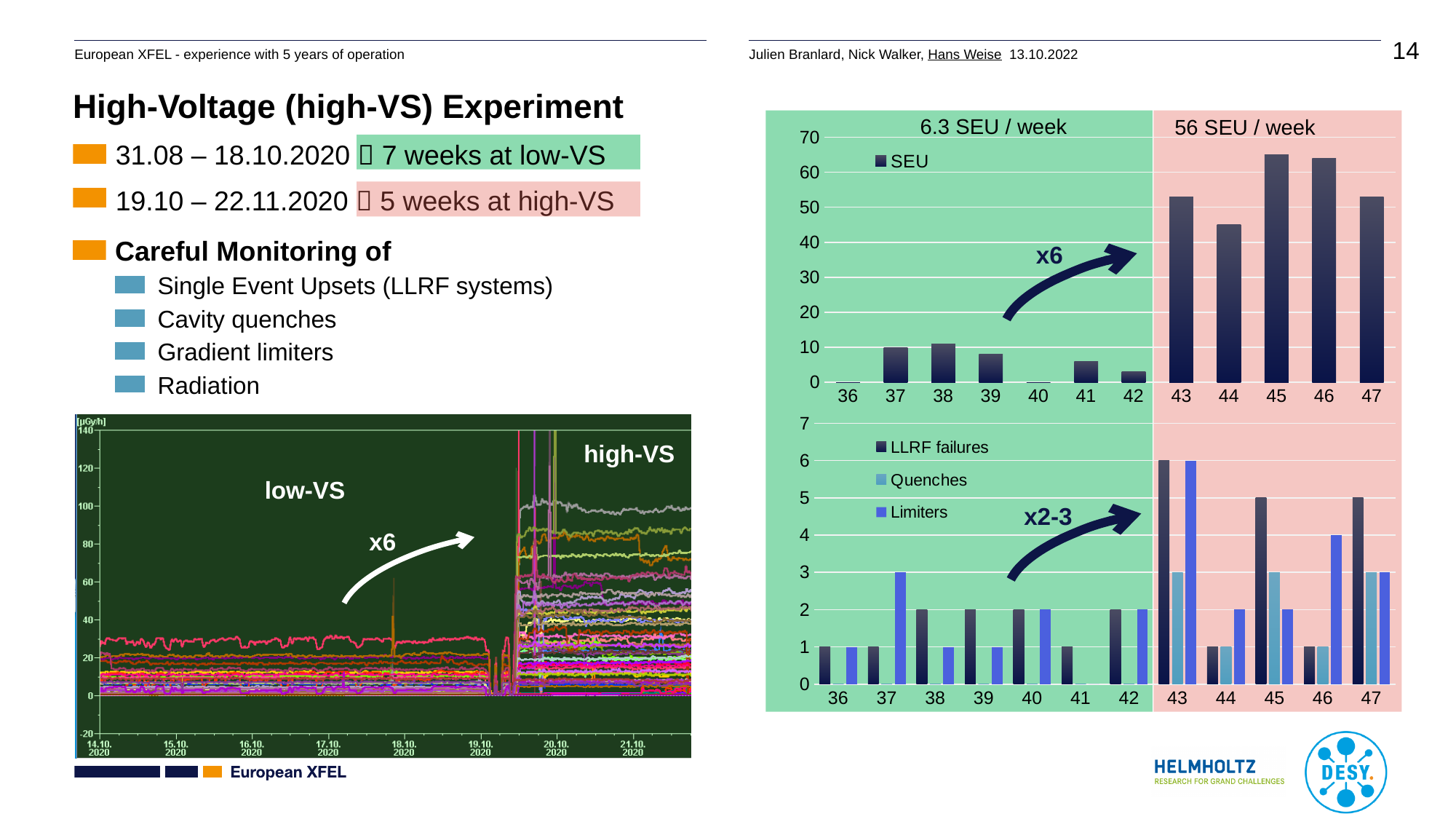
In the top-right SEU chart, what SEU rate per week is stated for the high-VS (red) period? 56 SEU / week In the bottom-right chart, how many series does the legend list? 3 In the top-right SEU chart, is the value for week 45 greater or less than 60? greater What kind of chart is the bottom-right chart? bar chart In the top-right SEU chart, is the value for week 44 greater or less than 40? greater In the bottom-right chart, what is the LLRF failures value for week 43? 6 In the bottom-right chart, what is the Quenches value for week 45? 3 In the top-right SEU chart, how many series does the legend list? 1 In the top-right SEU chart, is the value for week 38 greater or less than 20? less In the top-right SEU chart, which is larger, the value for week 43 or the value for week 42? week 43 In the bottom-right chart, what is the Limiters value for week 46? 4 In the top-right SEU chart, how many weeks are shown on the x axis? 12